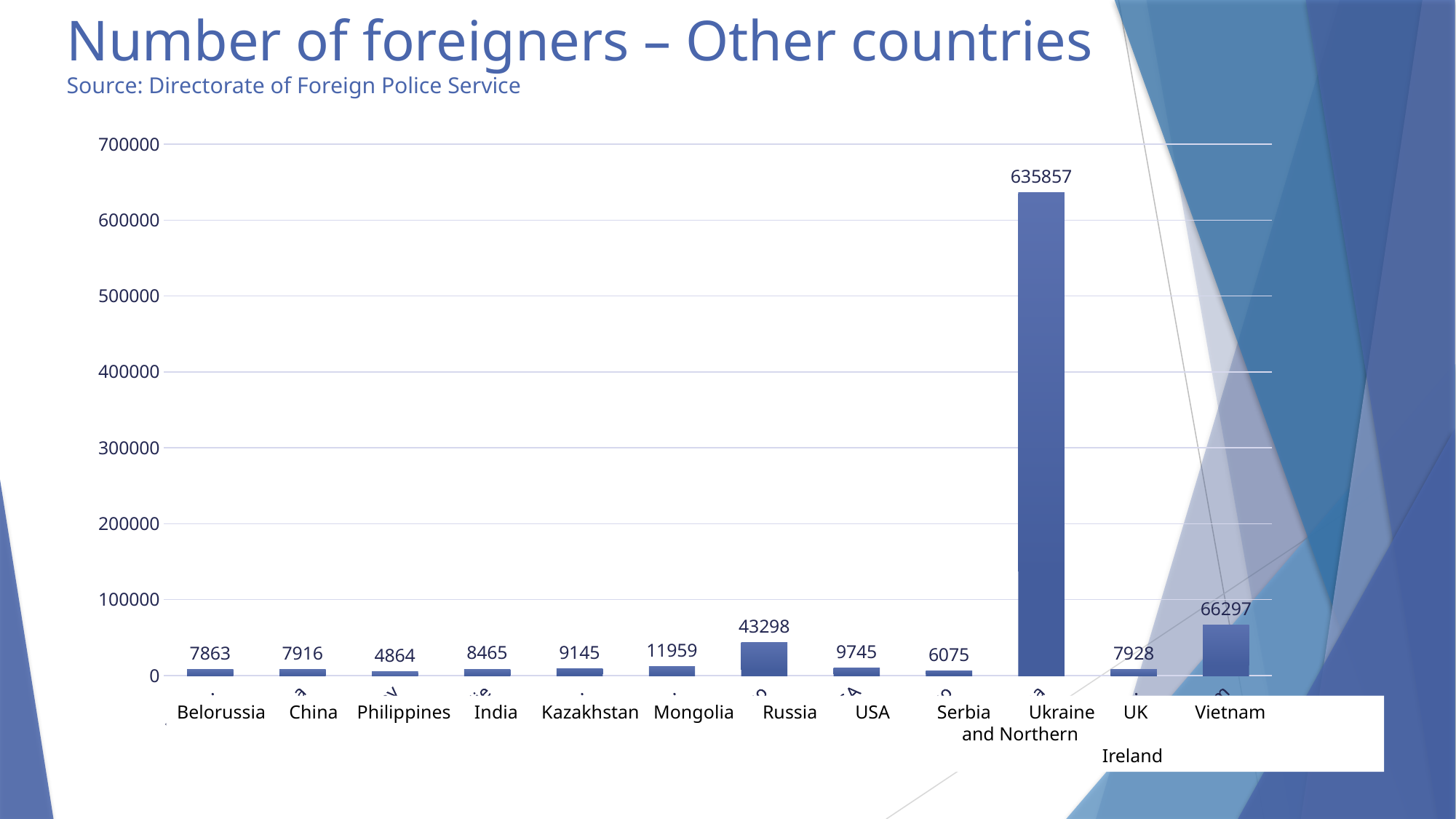
How many countries are shown on the chart? 12 Is the value for Ukraine greater or less than 600000? greater What is the source of the data given on the slide? Directorate of Foreign Police Service What is the number of foreigners from Ukraine? 635857 What is the difference between the number of foreigners from Vietnam and from Russia? 22999 Which has more foreigners, Kazakhstan or India? Kazakhstan Which country has the lowest number of foreigners? Philippines What kind of chart is shown on the slide? Bar chart What is the number of foreigners from Russia? 43298 Which country has the highest number of foreigners? Ukraine What is the number of foreigners from Mongolia? 11959 What is the number of foreigners from Vietnam? 66297